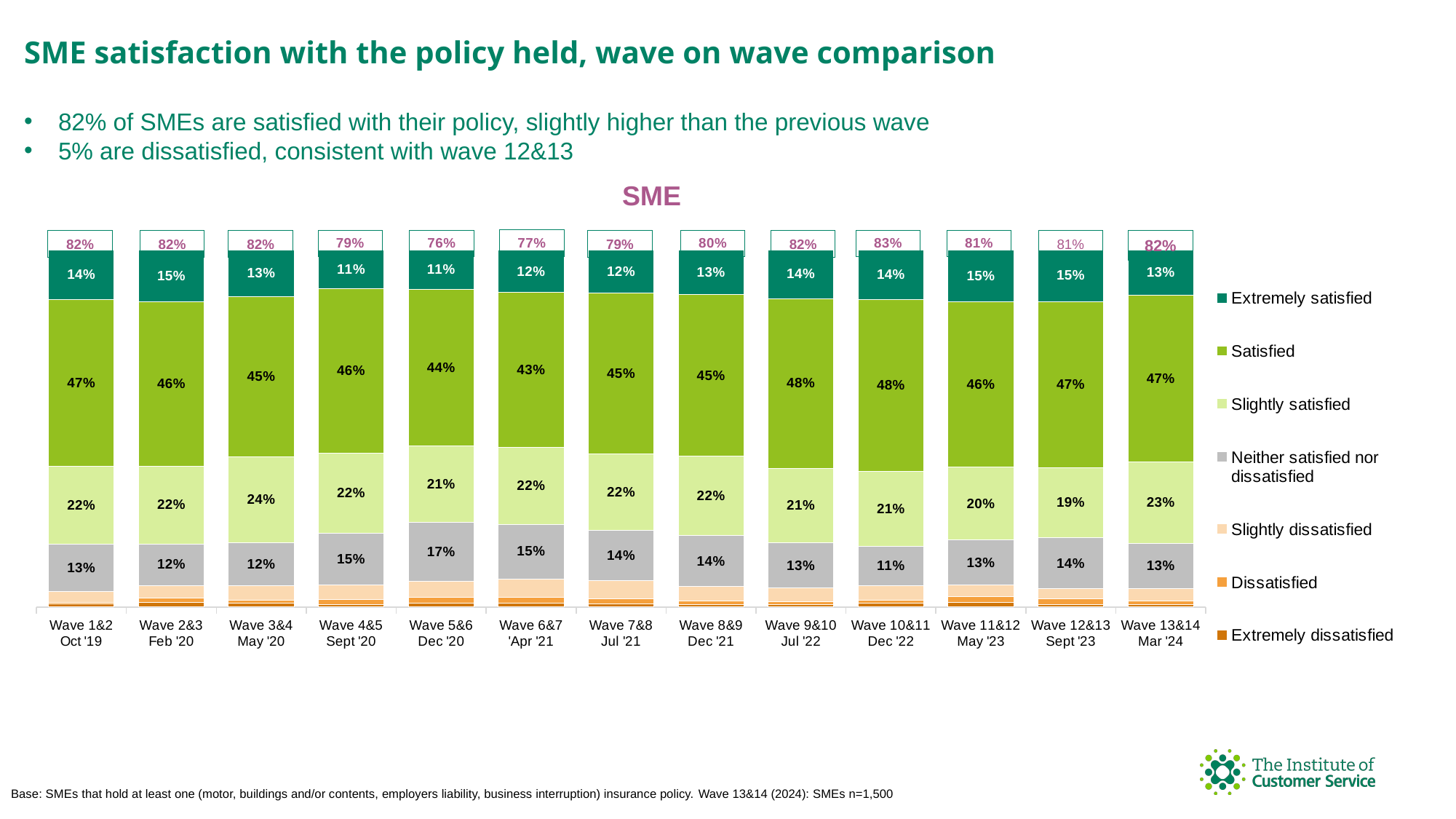
What is the difference in the 'Satisfied' value between Wave 1&2 Oct '19 and Wave 6&7 'Apr '21? 4 percentage points How many series does the legend list? 7 Which wave has the larger 'Extremely satisfied' value, Wave 2&3 Feb '20 or Wave 4&5 Sept '20? Wave 2&3 Feb '20 What overall satisfaction percentage is shown above the bar for Wave 10&11 Dec '22? 83% What percentage of SMEs were 'Extremely satisfied' in Wave 5&6 Dec '20? 11% What type of chart is shown on the slide? Stacked bar chart Which wave has the lowest overall satisfaction percentage shown above the bars? Wave 5&6 Dec '20 (76%) What is the 'Satisfied' value for Wave 9&10 Jul '22? 48% Which wave has the highest 'Neither satisfied nor dissatisfied' value? Wave 5&6 Dec '20 (17%) Does the 'Extremely satisfied' value rise or fall from Wave 5&6 Dec '20 to Wave 12&13 Sept '23? Rise How many waves are shown on the x axis of the chart? 13 What is the 'Slightly satisfied' value for Wave 3&4 May '20? 24%